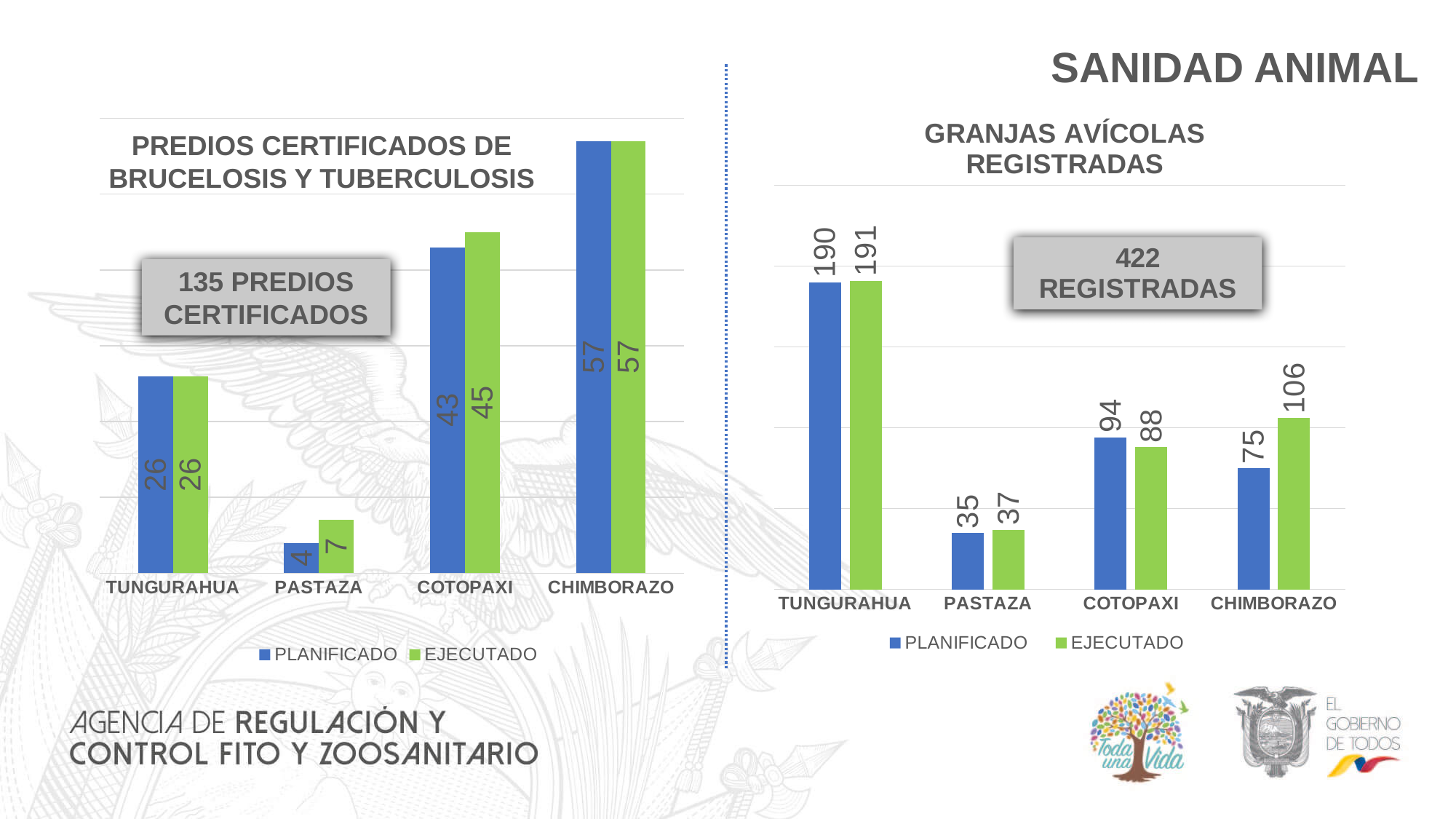
How many series does the legend of the 'PREDIOS CERTIFICADOS DE BRUCELOSIS Y TUBERCULOSIS' chart list? 2 In the 'PREDIOS CERTIFICADOS DE BRUCELOSIS Y TUBERCULOSIS' chart, which province has the highest EJECUTADO value? CHIMBORAZO In the 'GRANJAS AVÍCOLAS REGISTRADAS' chart, which province has the lowest EJECUTADO value? PASTAZA In the 'GRANJAS AVÍCOLAS REGISTRADAS' chart, which is larger for COTOPAXI, PLANIFICADO or EJECUTADO? PLANIFICADO In the 'PREDIOS CERTIFICADOS DE BRUCELOSIS Y TUBERCULOSIS' chart, what is the difference between the EJECUTADO and PLANIFICADO values for PASTAZA? 3 How many provinces are shown on the x axis of the 'GRANJAS AVÍCOLAS REGISTRADAS' chart? 4 In the 'PREDIOS CERTIFICADOS DE BRUCELOSIS Y TUBERCULOSIS' chart, what is the PLANIFICADO value for PASTAZA? 4 In the 'GRANJAS AVÍCOLAS REGISTRADAS' chart, what is the difference between the EJECUTADO and PLANIFICADO values for CHIMBORAZO? 31 In the 'GRANJAS AVÍCOLAS REGISTRADAS' chart, what is the PLANIFICADO value for TUNGURAHUA? 190 In the 'PREDIOS CERTIFICADOS DE BRUCELOSIS Y TUBERCULOSIS' chart, what is the EJECUTADO value for COTOPAXI? 45 In the 'PREDIOS CERTIFICADOS DE BRUCELOSIS Y TUBERCULOSIS' chart, which province has the lowest PLANIFICADO value? PASTAZA In the 'GRANJAS AVÍCOLAS REGISTRADAS' chart, what is the EJECUTADO value for CHIMBORAZO? 106